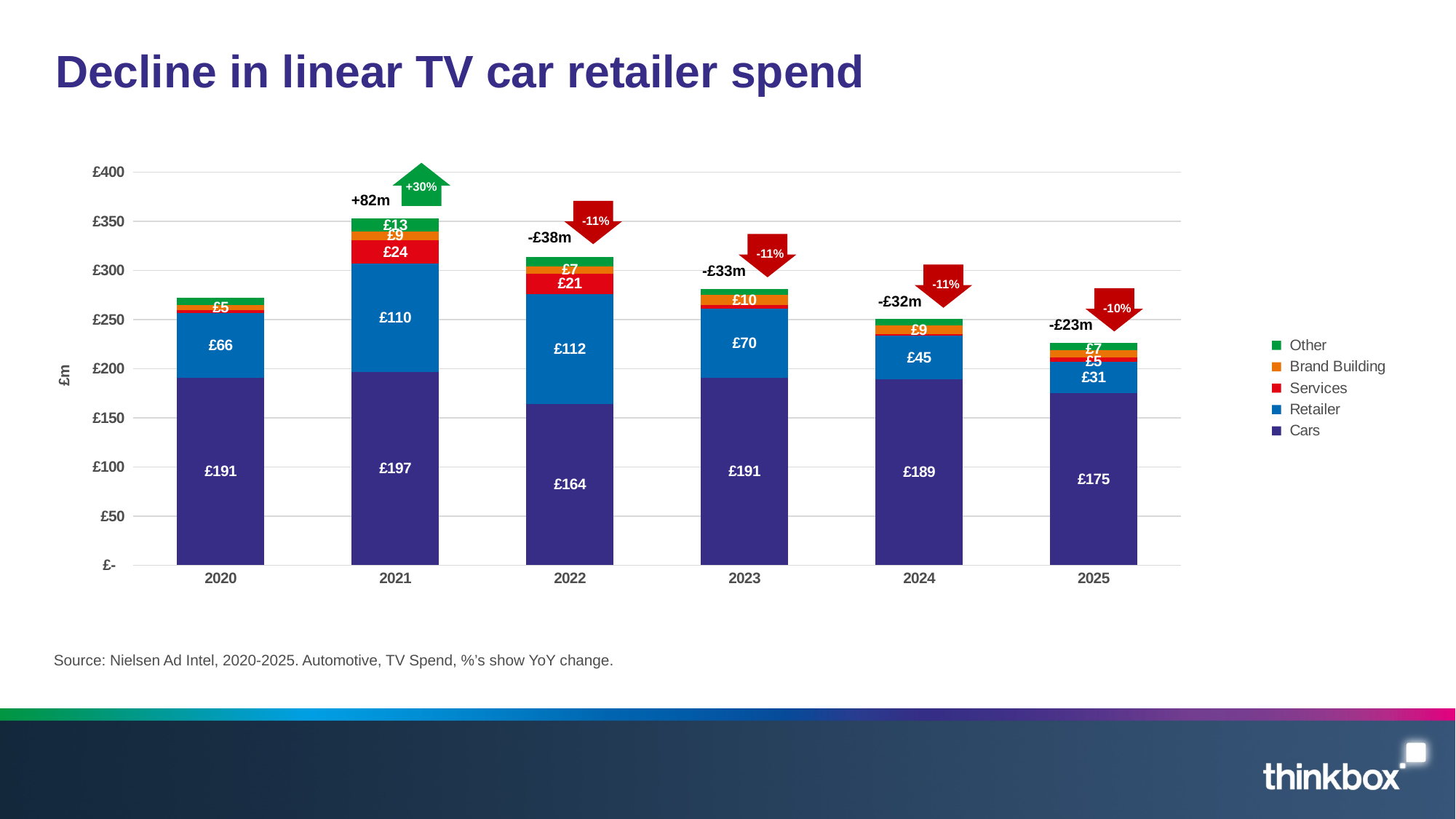
How many series does the legend list? 5 What kind of chart is shown on the slide? Stacked bar chart How many years are shown on the x axis? 6 What is the difference between the Retailer value in 2021 and in 2024? £65 What year-on-year percentage change is shown above the 2021 bar? +30% Which year has the larger Cars value, 2023 or 2024? 2023 What is the value for Retailer in 2022? £112 What is the value for Retailer in 2025? £31 In which year is the Cars segment lowest? 2022 What is the value for Cars in 2021? £197 In which year is the Retailer segment highest? 2022 Is the total height of the 2025 bar greater or less than £250? less